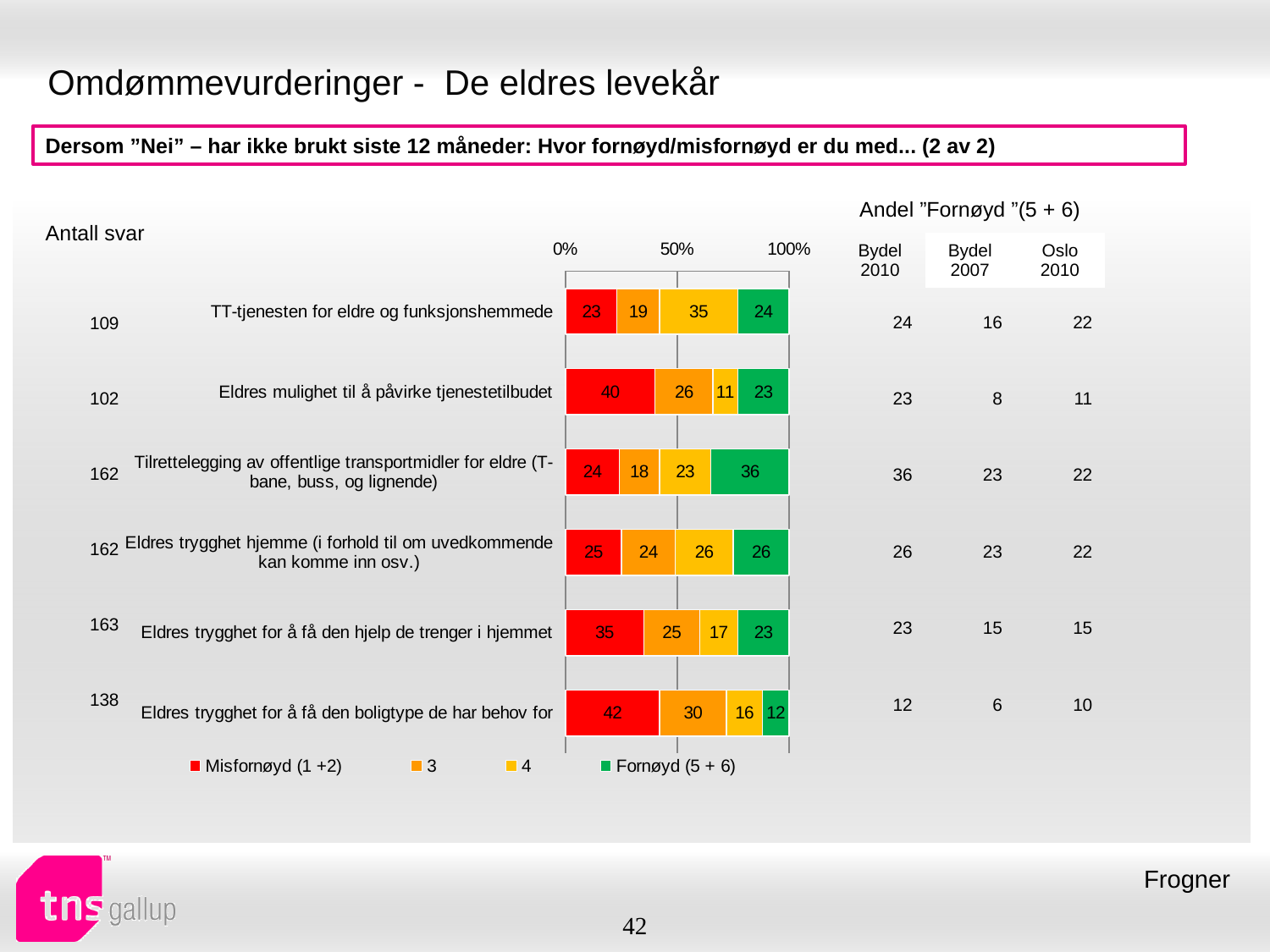
What is the total of the stacked bar for "Eldres trygghet for å få den hjelp de trenger i hjemmet"? 100 What kind of chart is shown on the slide? Stacked bar chart What is the Misfornøyd (1 +2) value for "Eldres trygghet for å få den boligtype de har behov for"? 42 How many series does the legend list? 4 Which category has the highest Misfornøyd (1 +2) value? Eldres trygghet for å få den boligtype de har behov for What is the difference between the Misfornøyd (1 +2) values for "Eldres mulighet til å påvirke tjenestetilbudet" and "TT-tjenesten for eldre og funksjonshemmede"? 17 What is the value of series "4" for "Eldres mulighet til å påvirke tjenestetilbudet"? 11 What is the Fornøyd (5 + 6) value for "TT-tjenesten for eldre og funksjonshemmede"? 24 Which category has the highest Fornøyd (5 + 6) value? Tilrettelegging av offentlige transportmidler for eldre (T-bane, buss, og lignende) Which category has the lowest Fornøyd (5 + 6) value? Eldres trygghet for å få den boligtype de har behov for Which is larger: the Fornøyd (5 + 6) value for "Eldres trygghet hjemme (i forhold til om uvedkommende kan komme inn osv.)" or for "Eldres trygghet for å få den hjelp de trenger i hjemmet"? Eldres trygghet hjemme (i forhold til om uvedkommende kan komme inn osv.) How many categories are shown in the chart? 6